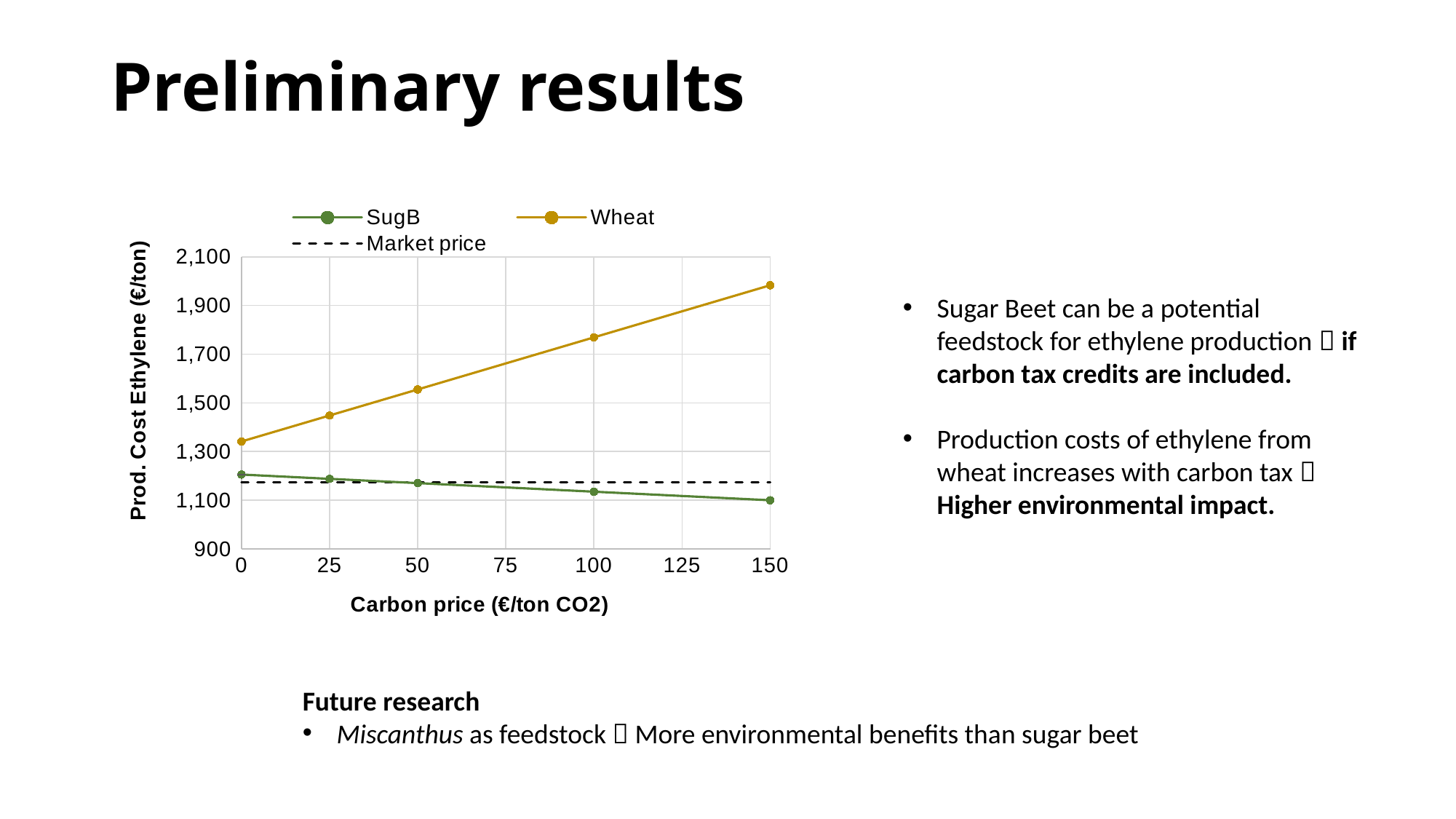
What is the title of the y axis of the chart? Prod. Cost Ethylene (€/ton) At a carbon price of 150, which series has the higher production cost, SugB or Wheat? Wheat Is the value for SugB at a carbon price of 150 greater or less than 1,300? less Is the value for Wheat at a carbon price of 50 greater or less than 1,500? greater How many data points are plotted for the Wheat series? 5 Is the value for Wheat at a carbon price of 150 greater or less than 1,900? greater What kind of chart is shown on the slide? line chart Does the production cost for SugB rise or fall as the carbon price increases? fall Does the production cost for Wheat rise or fall as the carbon price increases? rise What is the title of the x axis of the chart? Carbon price (€/ton CO2) How many entries does the chart legend list? 3